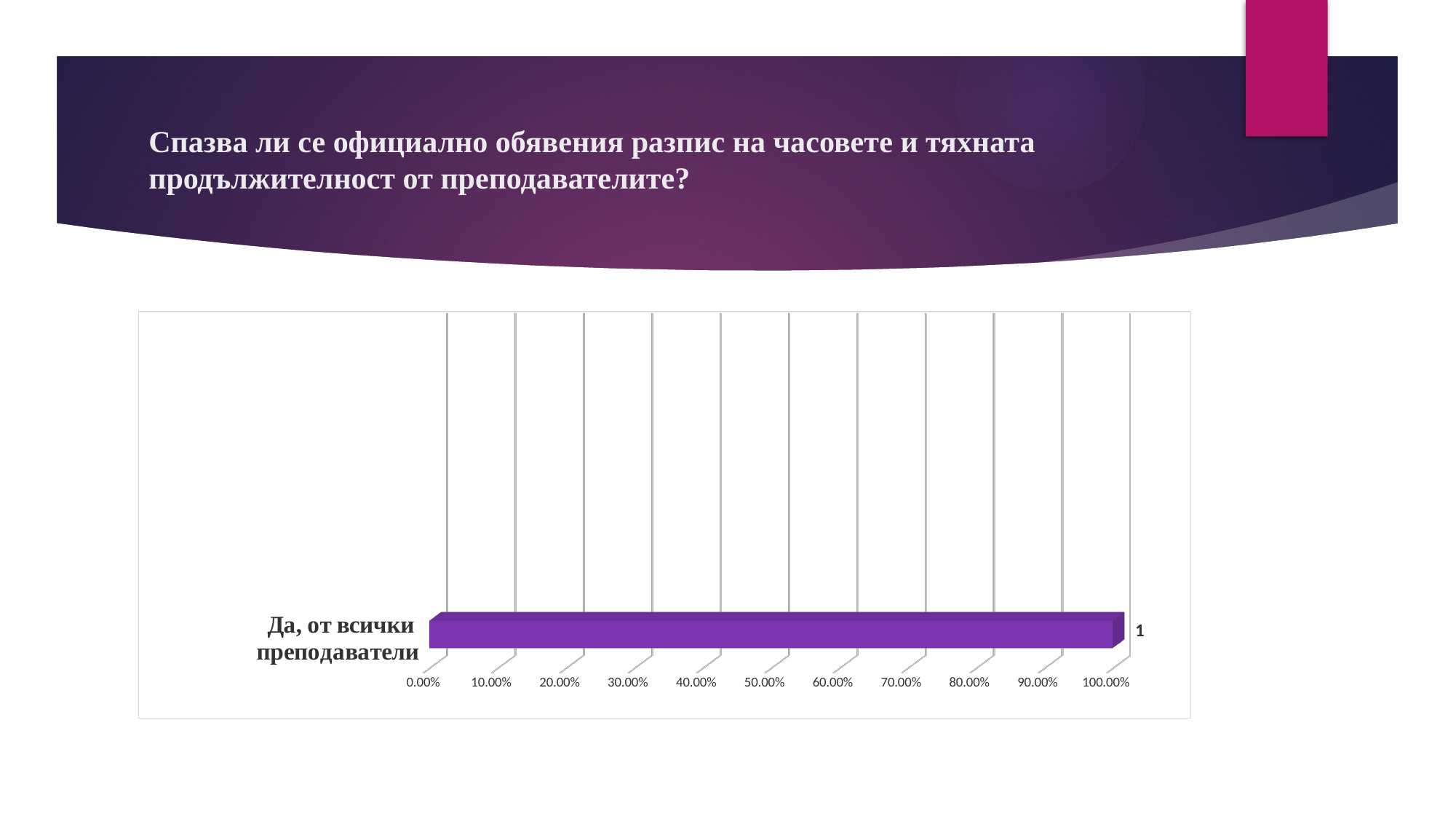
How many categories are plotted in the chart? 1 What is the data label shown next to the bar for "Да, от всички преподаватели"? 1 What is the highest tick value shown on the x axis of the chart? 100.00% What kind of chart is shown on the slide? bar chart Is the value for "Да, от всички преподаватели" greater or less than 50.00%? greater Is the value for "Да, от всички преподаватели" greater or less than 90.00%? greater Which axis tick does the bar for "Да, от всички преподаватели" reach on the x axis? 100.00% What is the label of the only category shown in the chart? Да, от всички преподаватели What colour is the bar in the chart? purple